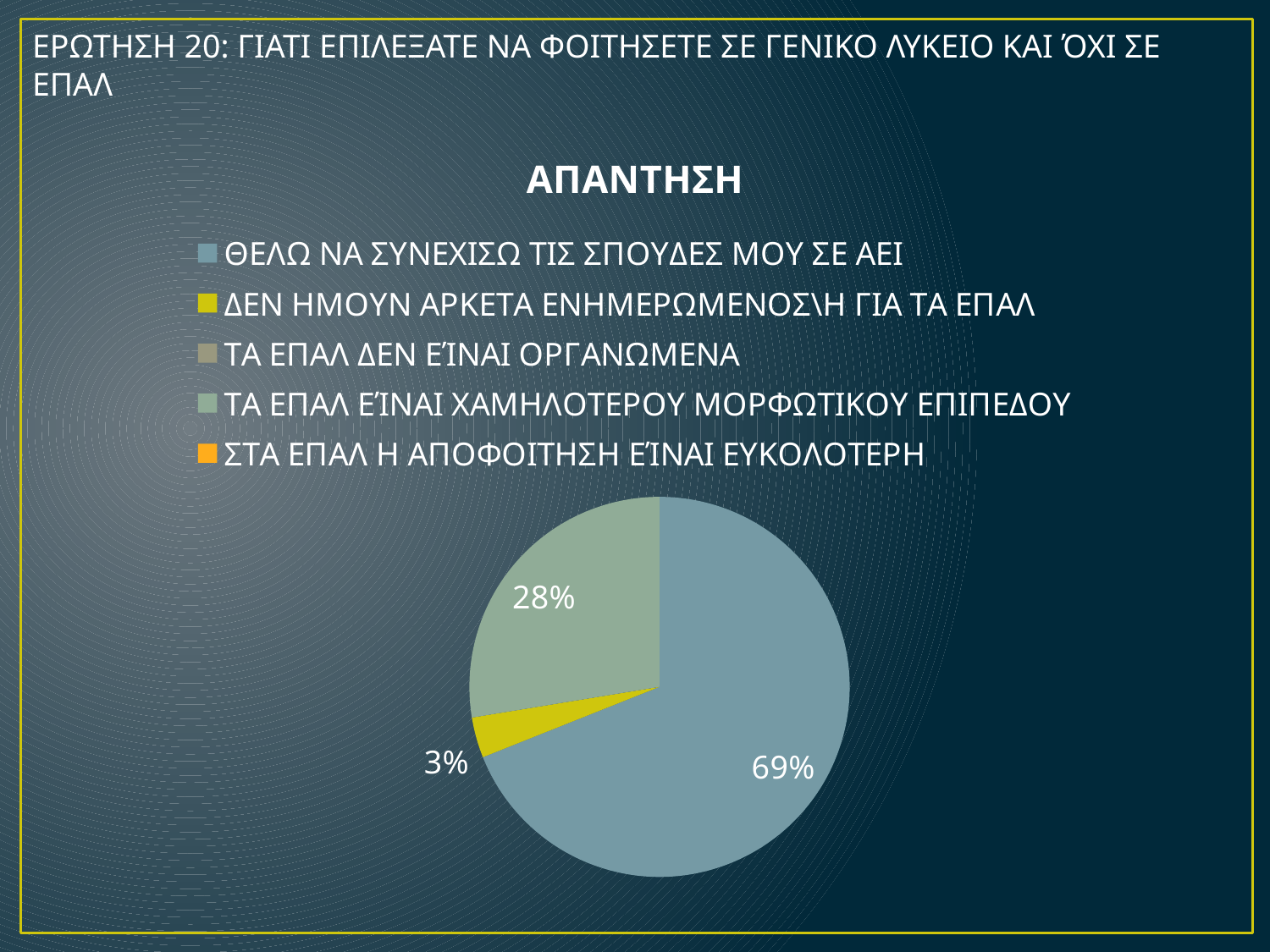
What is the title of the chart? ΑΠΑΝΤΗΣΗ Which is larger: the share for 'ΤΑ ΕΠΑΛ ΕΊΝΑΙ ΧΑΜΗΛΟΤΕΡΟΥ ΜΟΡΦΩΤΙΚΟΥ ΕΠΙΠΕΔΟΥ' or the share for 'ΔΕΝ ΗΜΟΥΝ ΑΡΚΕΤΑ ΕΝΗΜΕΡΩΜΕΝΟΣ\Η ΓΙΑ ΤΑ ΕΠΑΛ'? ΤΑ ΕΠΑΛ ΕΊΝΑΙ ΧΑΜΗΛΟΤΕΡΟΥ ΜΟΡΦΩΤΙΚΟΥ ΕΠΙΠΕΔΟΥ What percentage of the pie is labelled for 'ΔΕΝ ΗΜΟΥΝ ΑΡΚΕΤΑ ΕΝΗΜΕΡΩΜΕΝΟΣ\Η ΓΙΑ ΤΑ ΕΠΑΛ'? 3% How many slices of the pie have a percentage label printed on them? 3 What percentage of the pie is labelled for 'ΤΑ ΕΠΑΛ ΕΊΝΑΙ ΧΑΜΗΛΟΤΕΡΟΥ ΜΟΡΦΩΤΙΚΟΥ ΕΠΙΠΕΔΟΥ'? 28% Of the slices with a printed label, which answer has the smallest share? ΔΕΝ ΗΜΟΥΝ ΑΡΚΕΤΑ ΕΝΗΜΕΡΩΜΕΝΟΣ\Η ΓΙΑ ΤΑ ΕΠΑΛ Which answer has the largest share of the pie? ΘΕΛΩ ΝΑ ΣΥΝΕΧΙΣΩ ΤΙΣ ΣΠΟΥΔΕΣ ΜΟΥ ΣΕ ΑΕΙ What kind of chart is shown on the slide? pie chart What colour is the slice representing 'ΔΕΝ ΗΜΟΥΝ ΑΡΚΕΤΑ ΕΝΗΜΕΡΩΜΕΝΟΣ\Η ΓΙΑ ΤΑ ΕΠΑΛ'? yellow How many entries does the chart legend list? 5 What is the difference in percentage points between the 69% slice and the 28% slice? 41 What percentage of the pie is labelled for 'ΘΕΛΩ ΝΑ ΣΥΝΕΧΙΣΩ ΤΙΣ ΣΠΟΥΔΕΣ ΜΟΥ ΣΕ ΑΕΙ'? 69%